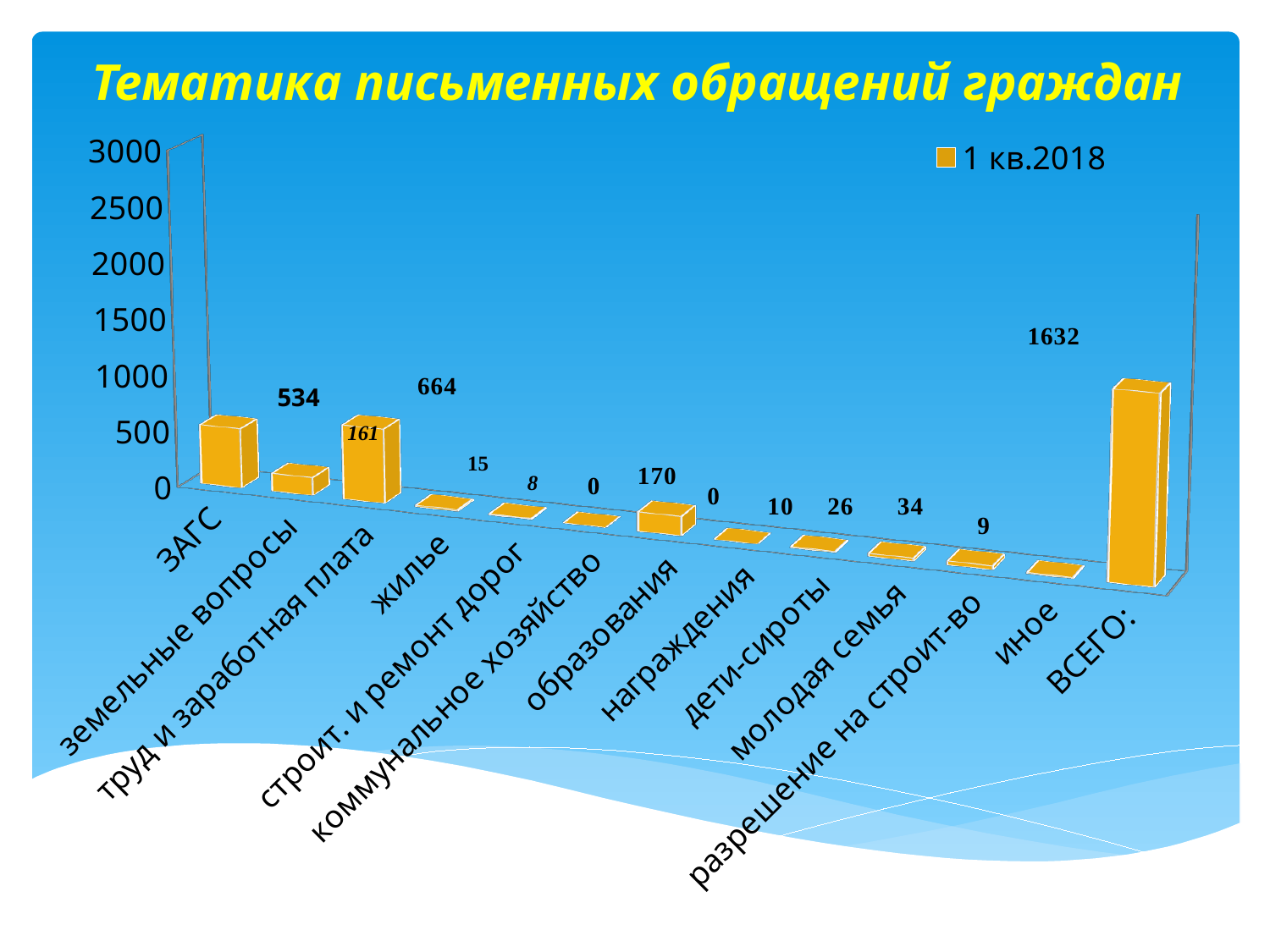
How many series does the legend list? 1 What is the difference between the values for труд и заработная плата and ЗАГС? 130 What is the legend entry for the series? 1 кв.2018 Which category has the highest value? ВСЕГО: How many categories are shown on the x axis? 13 What is the value for ВСЕГО:? 1632 What is the title of the chart? Тематика письменных обращений граждан Which is larger, the value for труд и заработная плата or the value for ЗАГС? труд и заработная плата Is the value for ВСЕГО: greater or less than 1500? greater What is the value for образования? 170 What kind of chart is shown on the slide? bar chart What is the value for труд и заработная плата? 664